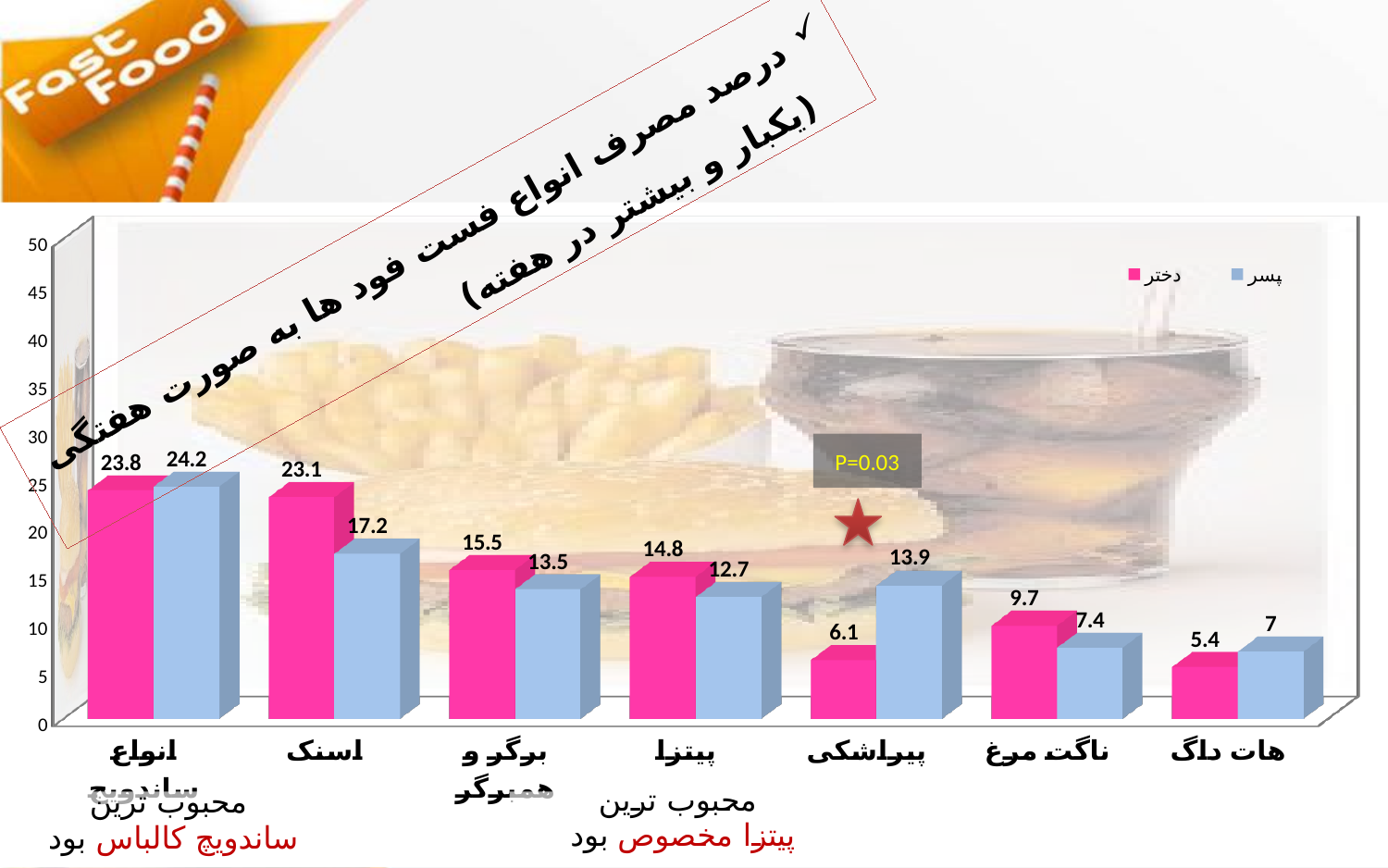
What P value is shown in the box above the پیراشکی bars? P=0.03 What is the value for پسر (boys) for ناگت مرغ? 7.4 How many series does the legend list? 2 What is the difference between the دختر and پسر values for اسنک? 5.9 What is the value for دختر (girls) for اسنک? 23.1 What is the value for دختر (girls) for هات داگ? 5.4 Which category has the highest value for پسر (boys)? انواع ساندویچ What is the value for پسر (boys) for پیراشکی? 13.9 How many categories are shown on the x axis? 7 For پیراشکی, which series has the larger value, دختر or پسر? پسر What kind of chart is shown on the slide? bar chart Which category has the lowest value for دختر (girls)? هات داگ